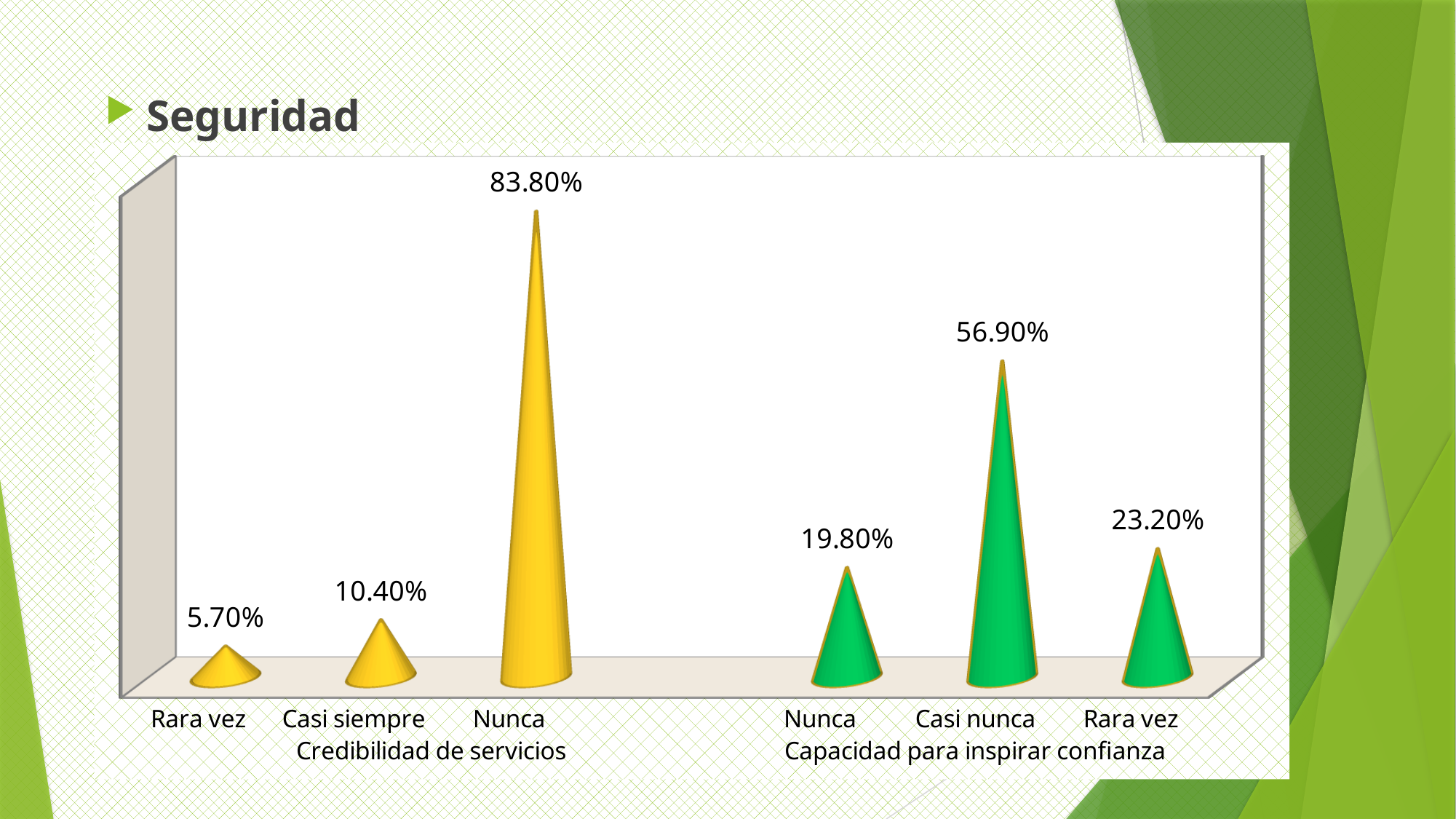
Which is larger: "Rara vez" under "Capacidad para inspirar confianza" or "Casi siempre" under "Credibilidad de servicios"? Rara vez (Capacidad para inspirar confianza) What is the value for "Rara vez" under "Credibilidad de servicios"? 5.70% How many categories are plotted in the chart? 6 What is the difference between "Casi nunca" and "Nunca" under "Capacidad para inspirar confianza"? 37.10% What is the value for "Rara vez" under "Capacidad para inspirar confianza"? 23.20% Which category has the highest value in the chart? Nunca (Credibilidad de servicios) Which category has the lowest value in the chart? Rara vez (Credibilidad de servicios) What is the value for "Casi nunca" under "Capacidad para inspirar confianza"? 56.90% What is the value for "Casi siempre" under "Credibilidad de servicios"? 10.40% What is the value for "Nunca" under "Credibilidad de servicios"? 83.80% What colour are the bars for the "Capacidad para inspirar confianza" group? Green What kind of chart is shown on the slide? Bar chart